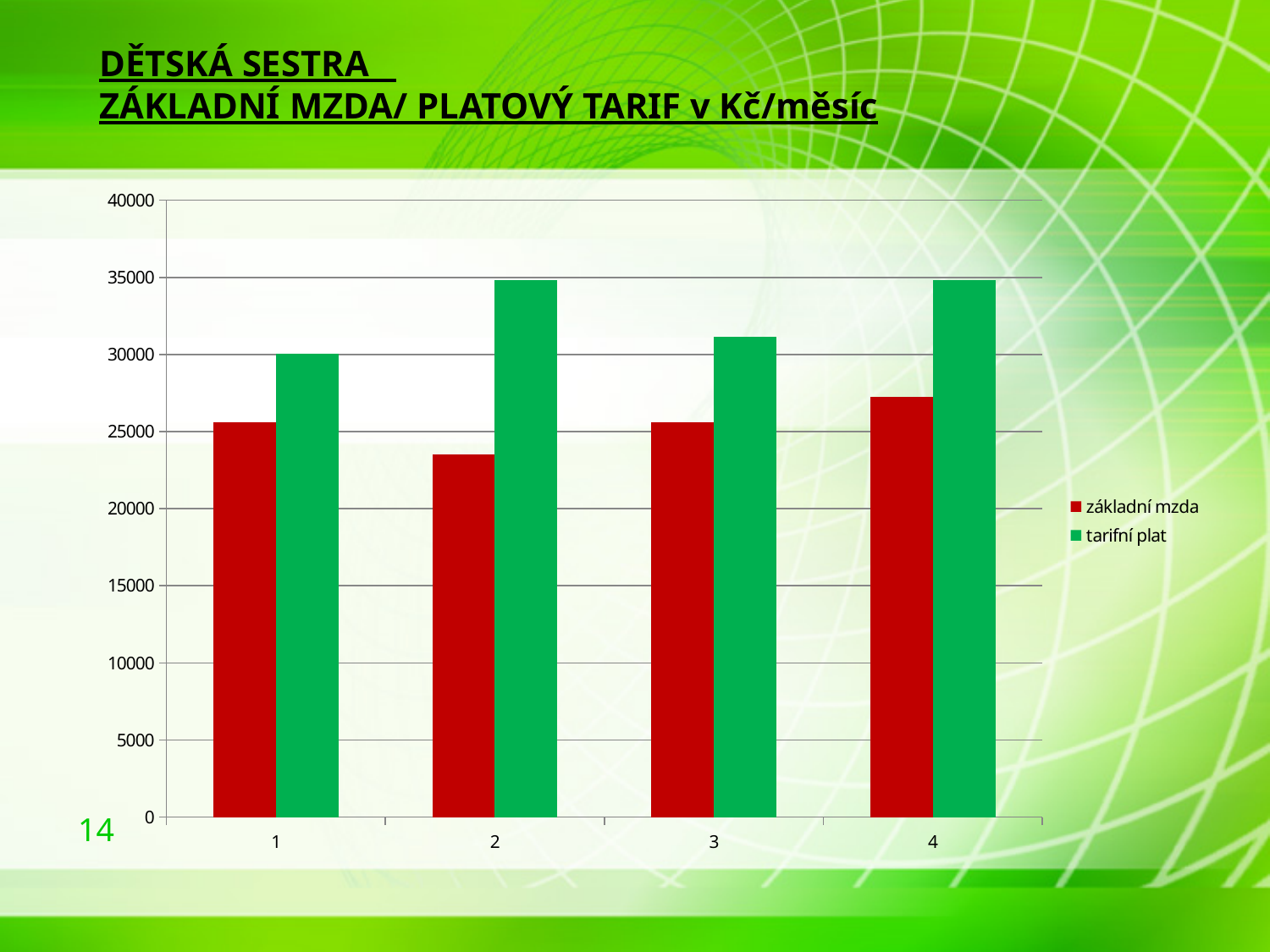
Is the value for základní mzda in category 2 greater or less than 25000? less In category 1, which is larger: základní mzda or tarifní plat? tarifní plat Is the value for tarifní plat in category 2 greater or less than 30000? greater How many series does the legend list? 2 What kind of chart is shown on the slide? bar chart Which category has the highest value for základní mzda? 4 Is the value for základní mzda in category 4 greater or less than 25000? greater What colour are the bars for základní mzda? red How many categories are shown on the x axis? 4 What are the two series listed in the legend? základní mzda, tarifní plat Which category has the lowest value for základní mzda? 2